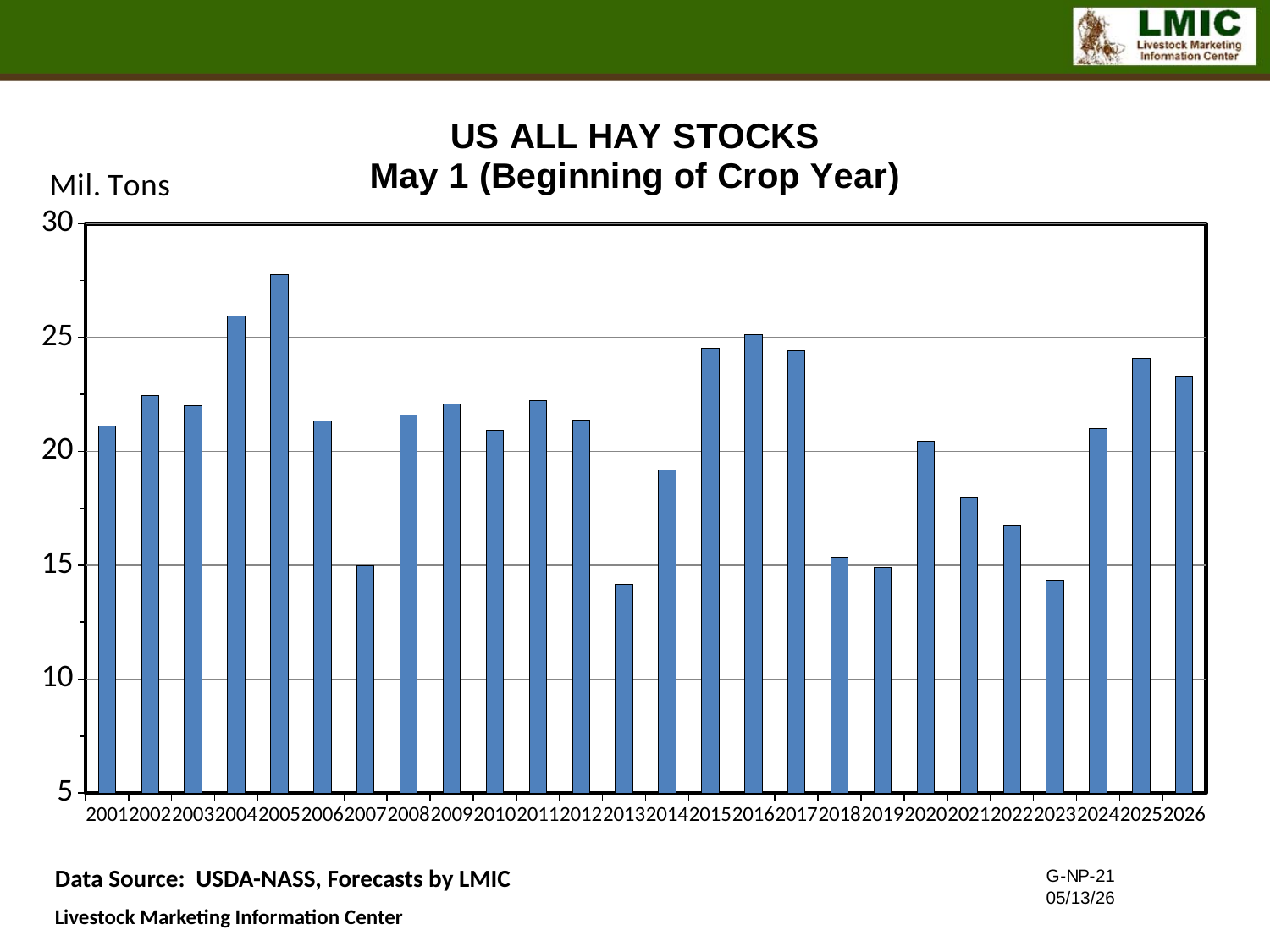
Do the values rise or fall from 2020 to 2023? fall Is the value for 2005 greater or less than 25? greater Is the value for 2013 greater or less than 15? less Which year has the highest US all hay stocks on May 1? 2005 Which year has the larger value, 2004 or 2005? 2005 Which year has the larger value, 2014 or 2015? 2015 Is the value for 2025 greater or less than 25? less What kind of chart is shown on the slide? Bar chart What unit is shown on the vertical axis label? Mil. Tons How many years (bars) are plotted on the chart? 26